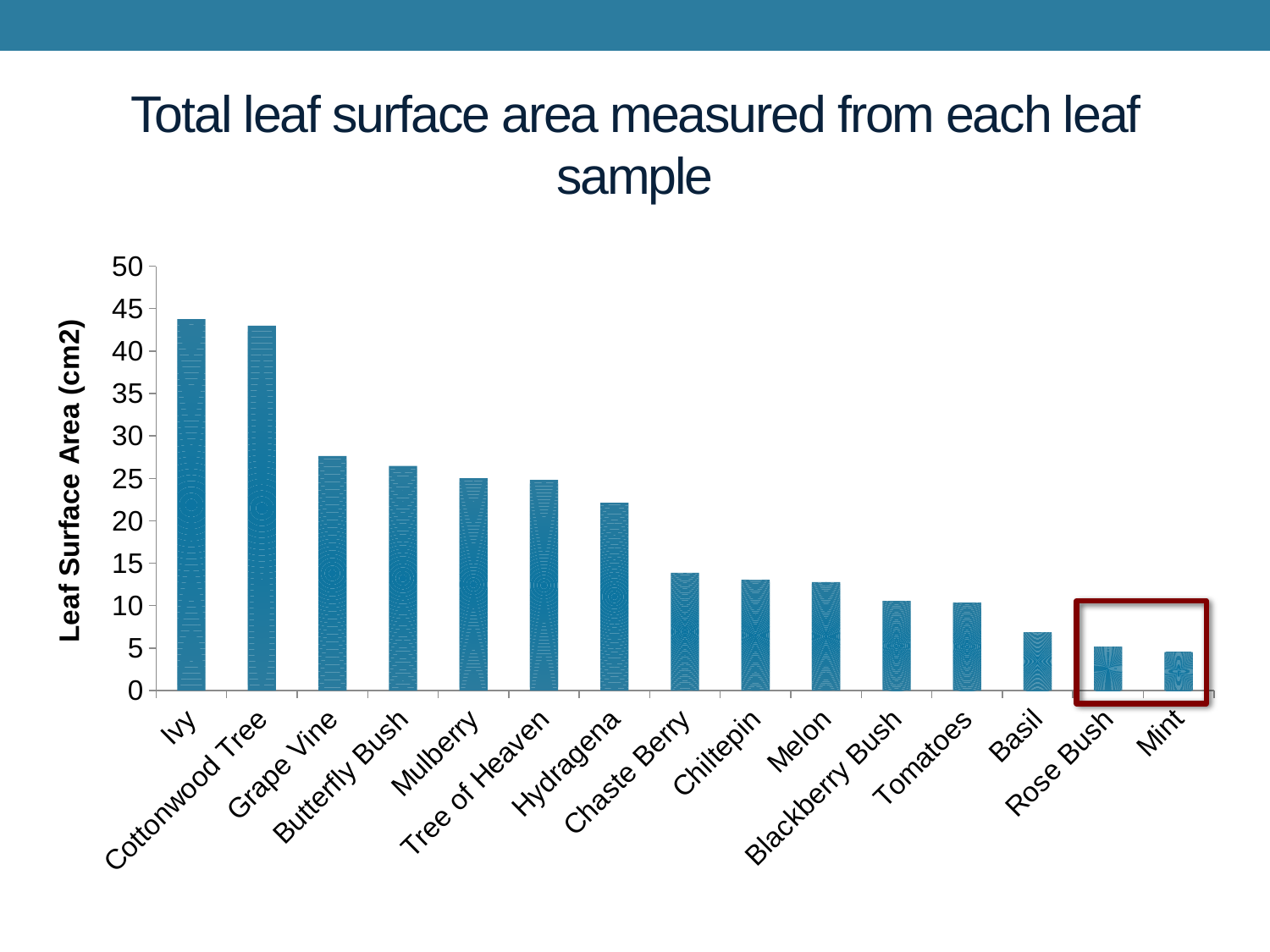
Is the value for Basil greater or less than 5? greater Is the value for Chaste Berry greater or less than 15? less Which has a larger leaf surface area, Grape Vine or Chaste Berry? Grape Vine How many leaf samples (categories) are plotted on the chart? 15 Which leaf sample has the highest total leaf surface area? Ivy Is the value for Hydragena greater or less than 20? greater What is the label on the vertical axis of the chart? Leaf Surface Area (cm2) Which leaf sample has the lowest total leaf surface area? Mint Do the values rise or fall moving from left to right along the x axis? fall What kind of chart is shown on the slide? bar chart